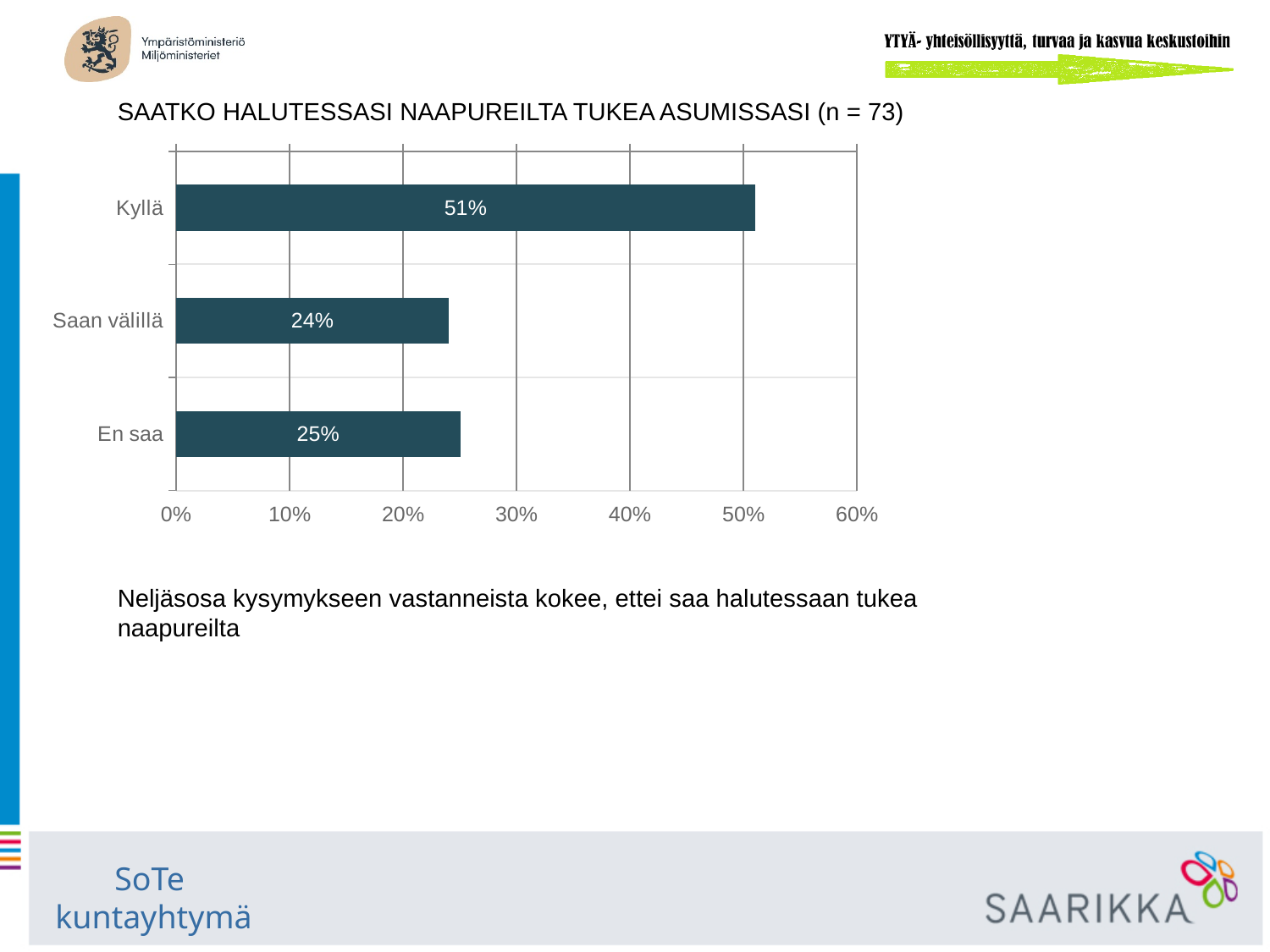
Is the value for Kyllä greater or less than 50%? greater What is the title of the chart? SAATKO HALUTESSASI NAAPUREILTA TUKEA ASUMISSASI (n = 73) What kind of chart is shown on the slide? bar chart What is the value for Kyllä? 51% How many categories are shown in the chart? 3 What is the value for En saa? 25% Which category has the highest value? Kyllä What is the difference between the values for En saa and Saan välillä? 1% Which is larger, the value for Kyllä or the value for Saan välillä? Kyllä What is the value for Saan välillä? 24% Which category has the lowest value? Saan välillä What is the difference between the values for Kyllä and En saa? 26%